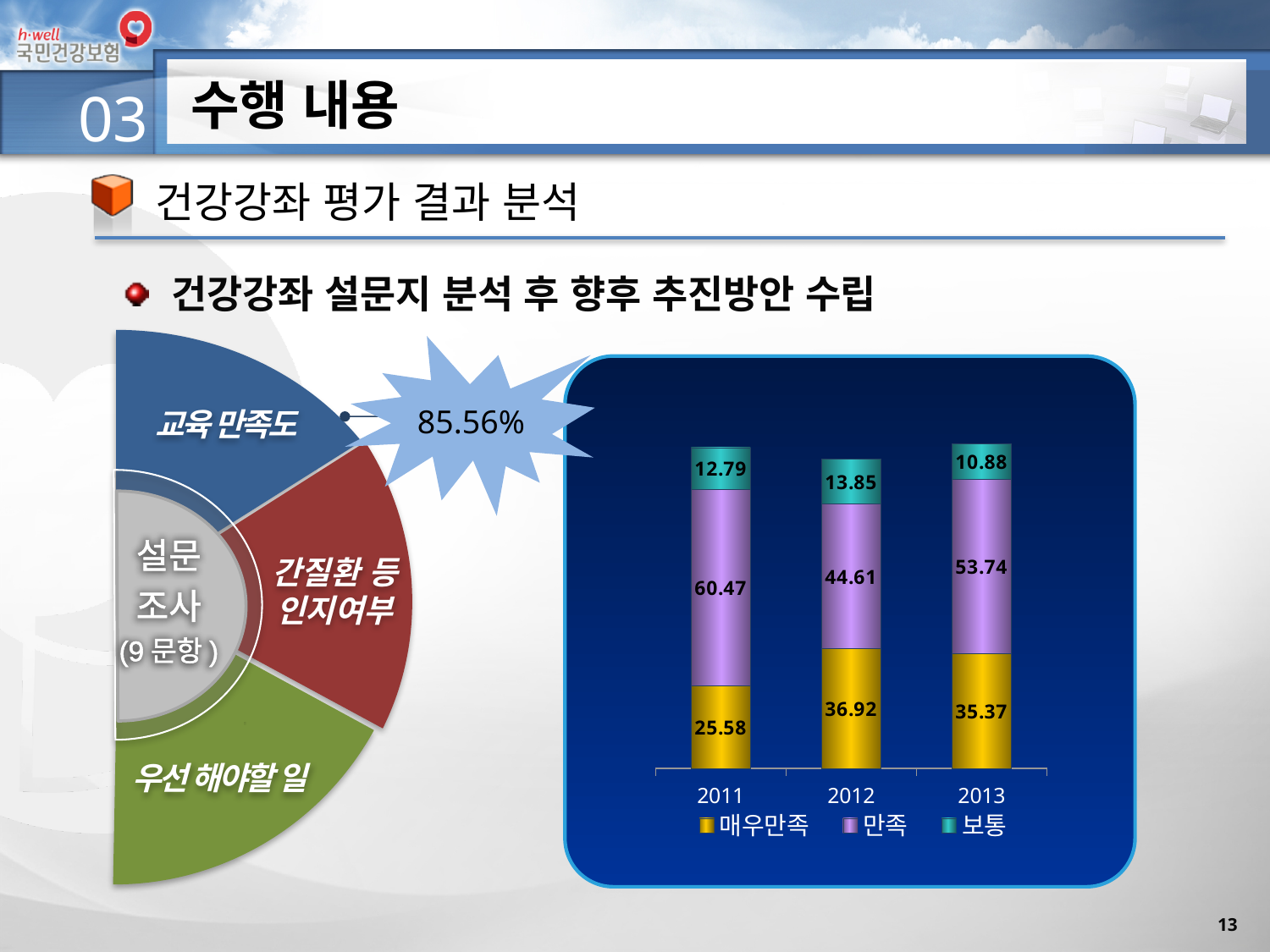
What is the total of the stacked bar for 2012? 95.38 What is the value for 만족 in 2011? 60.47 In which year is the 매우만족 value lowest? 2011 How many years are shown on the x axis of the chart? 3 What is the value for 매우만족 in 2012? 36.92 In which year is the 만족 value highest? 2011 How many series does the chart legend list? 3 What kind of chart is shown on the slide? stacked bar chart Which legend entry is shown in yellow? 매우만족 What is the value for 보통 in 2013? 10.88 What is the difference between the 만족 values for 2011 and 2012? 15.86 Which is larger, the 보통 value for 2012 or for 2013? 2012